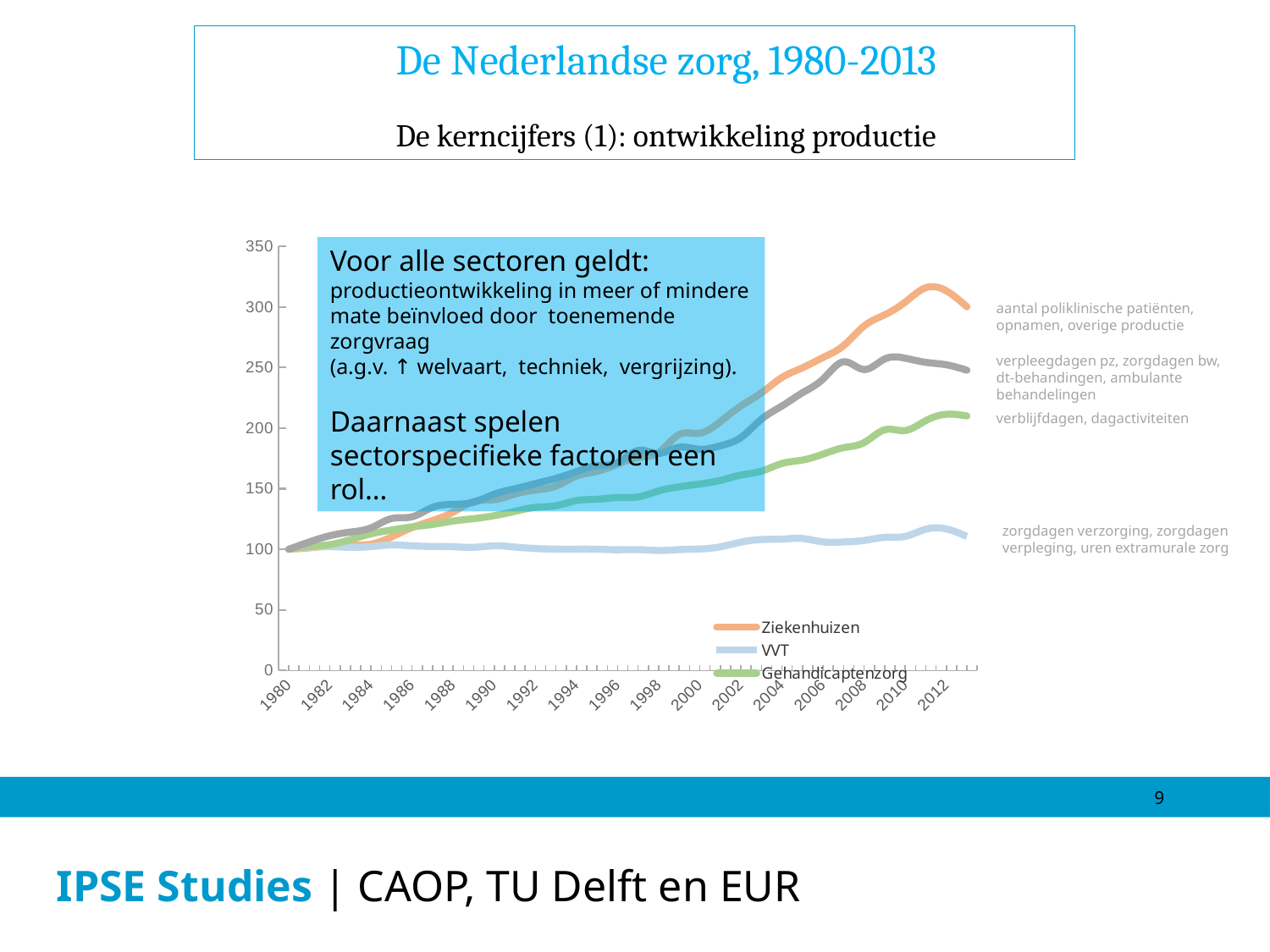
How many year labels are shown on the x axis? 17 Which series has the lowest value at the end of the period (2012)? VVT What kind of chart is shown on the slide? line chart Which series has the highest value at the end of the period (2012)? Ziekenhuizen Does the Ziekenhuizen series rise or fall between 1980 and 2010? rise What colour is the Ziekenhuizen line in the legend? orange Is the value for VVT in 2012 greater or less than 150? less How many series does the chart's legend list? 3 Is the value for Gehandicaptenzorg in 2012 greater or less than 150? greater At what value do all the series start in 1980? 100 In 2012, which is larger: the value for Ziekenhuizen or the value for VVT? Ziekenhuizen